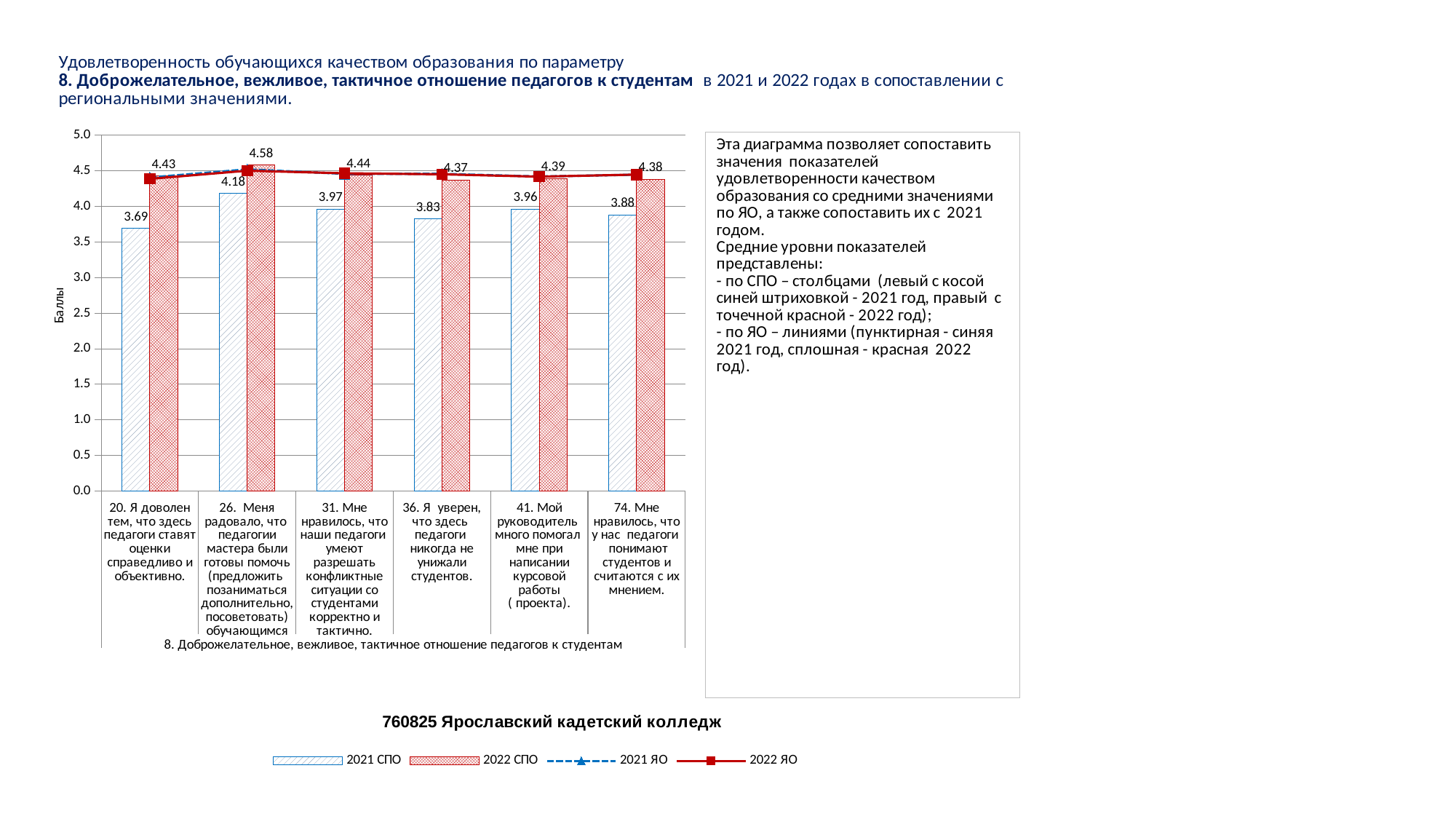
What is the 2021 СПО value for item 74 (Мне нравилось, что у нас педагоги понимают студентов и считаются с их мнением)? 3.88 What is the 2021 СПО value for item 20 (Я доволен тем, что здесь педагоги ставят оценки справедливо и объективно)? 3.69 Which item has the lowest 2022 СПО value? 36. Я уверен, что здесь педагоги никогда не унижали студентов Which item has the highest 2021 СПО value? 26. Меня радовало, что педагоги мастера были готовы помочь Which item has the lowest 2021 СПО value? 20. Я доволен тем, что здесь педагоги ставят оценки справедливо и объективно What is the 2022 СПО value for item 26 (Меня радовало, что педагоги мастера были готовы помочь)? 4.58 How many series does the legend list? 4 Is the 2021 СПО value for item 41 greater or less than 4.0? less What is the difference between the 2022 СПО and 2021 СПО values for item 20? 0.74 How many items (categories) are shown on the x axis? 6 What is the 2022 СПО value for item 36 (Я уверен, что здесь педагоги никогда не унижали студентов)? 4.37 Which is larger for item 31: the 2021 СПО value or the 2022 СПО value? 2022 СПО